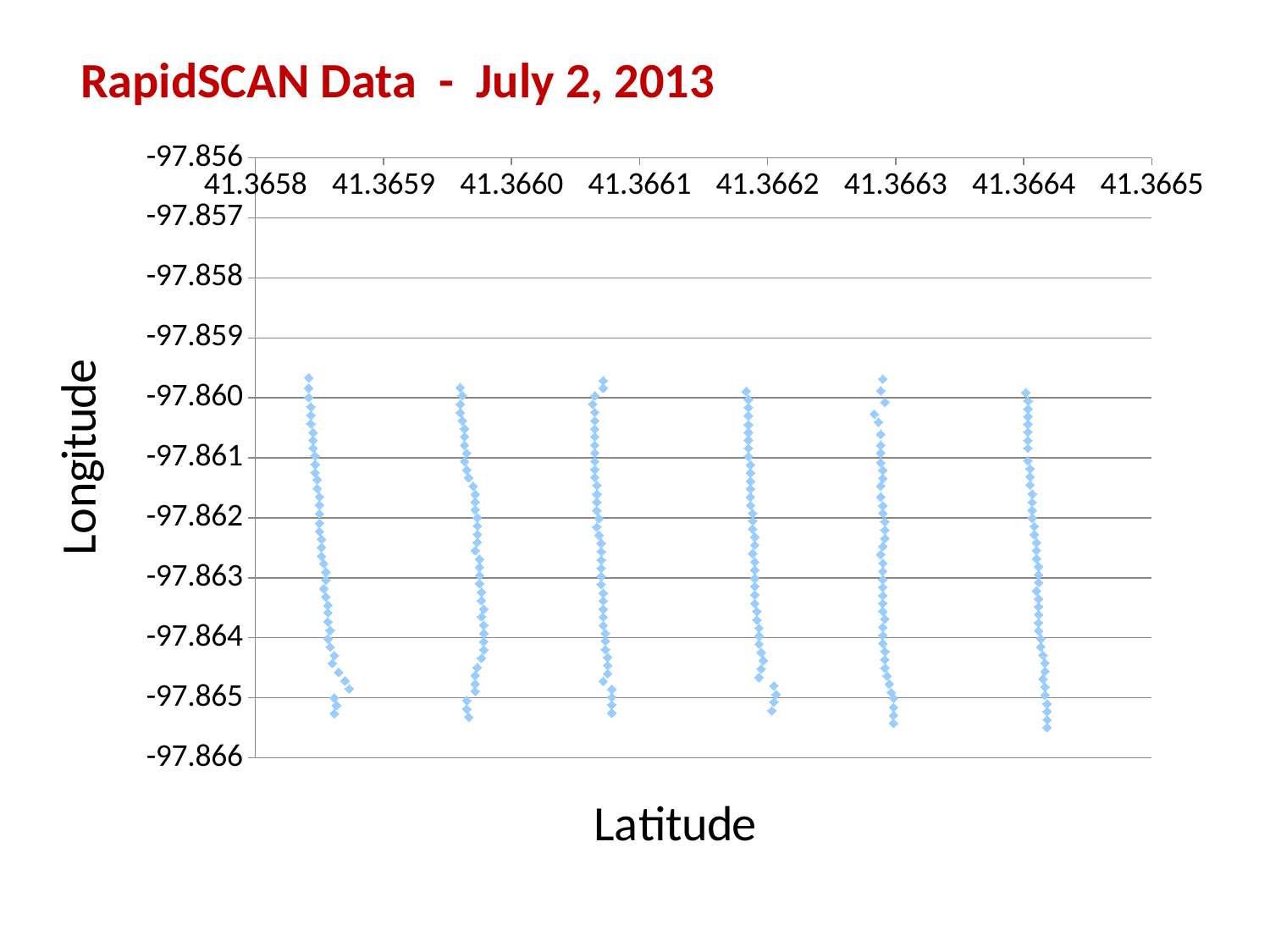
What are the labels of the x axis and the y axis of the chart? Latitude (x axis) and Longitude (y axis) Do all of the plotted points fall between latitude 41.3658 and 41.3665 on the x axis? Yes How many separate vertical strips of points are plotted on the chart? 6 Does the lowest point of the rightmost strip lie above or below the -97.865 gridline? Below Does the topmost point of the leftmost strip lie above or below the -97.860 gridline? Above What kind of chart is shown on the slide? Scatter chart What is the title of the chart? RapidSCAN Data - July 2, 2013